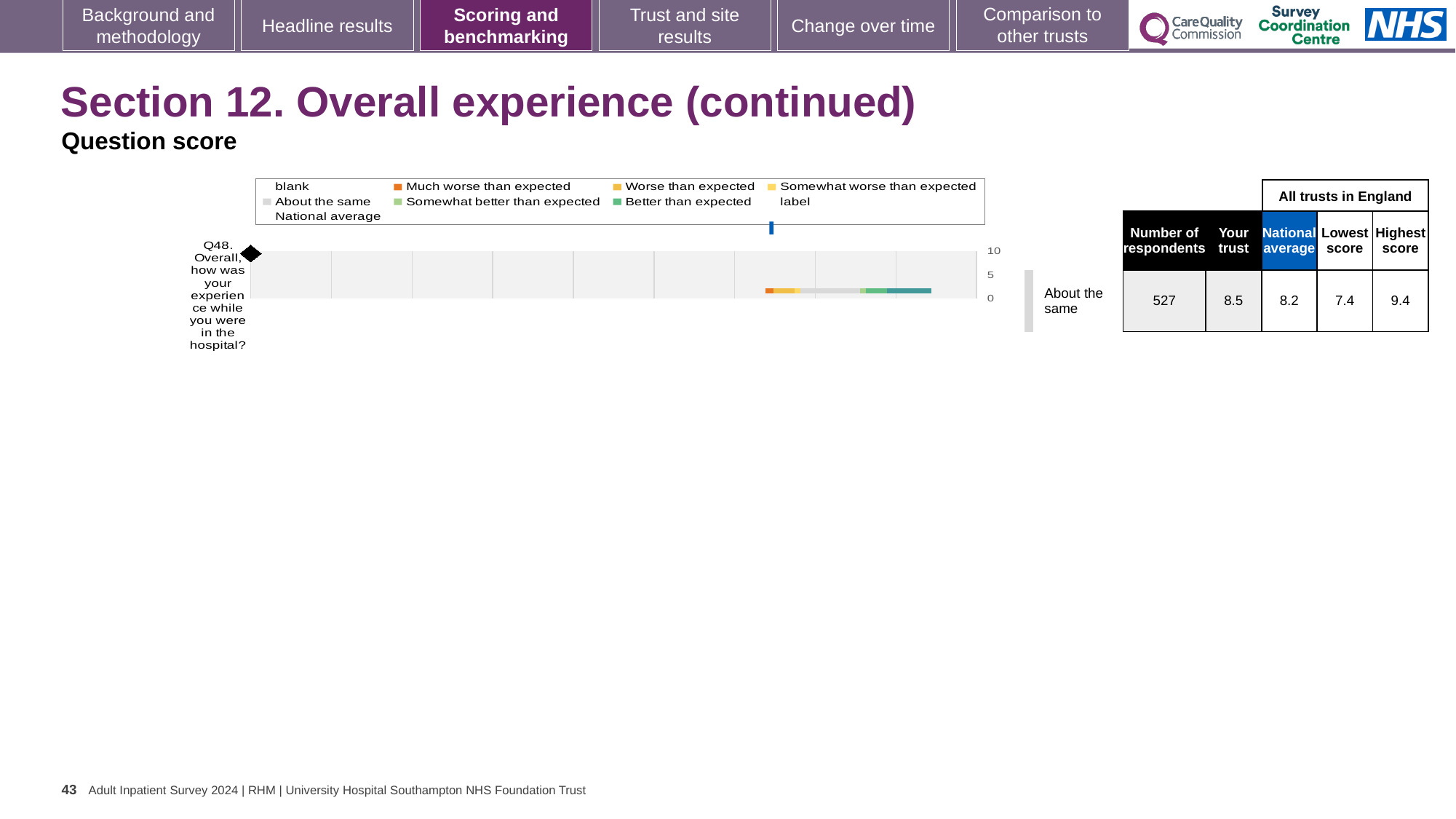
What kind of chart is used to show the Q48 question score? bar chart What is the 'Your trust' score for Q48 (Overall, how was your experience while you were in the hospital?)? 8.5 How many survey questions are plotted on the chart? 1 What is the national average score for Q48? 8.2 What is the highest score among all trusts in England for Q48? 9.4 Which benchmark category is the trust's Q48 score placed in? About the same By how much does the 'Your trust' score exceed the national average for Q48? 0.3 What is the highest value shown on the chart's score axis? 10 Which is higher for Q48: the 'Your trust' score or the national average? Your trust What is the difference between the highest score and the lowest score for Q48? 2.0 How many respondents answered Q48? 527 What is the lowest score among all trusts in England for Q48? 7.4